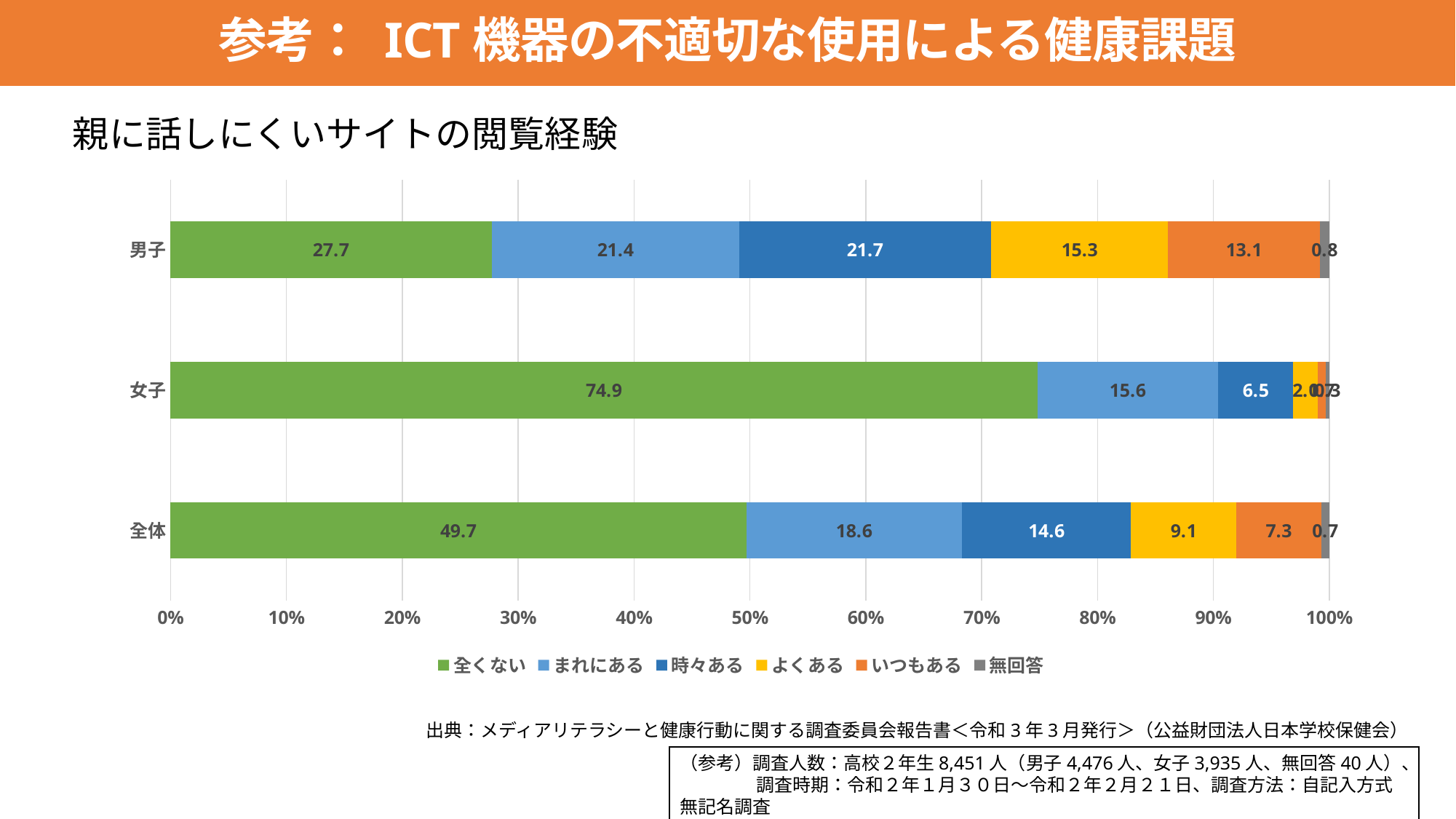
What is the value of 時々ある for 全体? 14.6 What is the value of 全くない for 女子? 74.9 How many series does the legend list? 6 Is the 全くない segment for 全体 greater or less than 40%? greater Which is larger, the まれにある value for 男子 or for 全体? 男子 Which category has the highest value for 全くない? 女子 What is the difference between the 全くない values for 女子 and 男子? 47.2 What is the value of いつもある for 男子? 13.1 How many categories are shown on the y axis? 3 Which category has the lowest value for 時々ある? 女子 What kind of chart is shown on the slide? Stacked bar chart What is the value of 全くない for 男子? 27.7